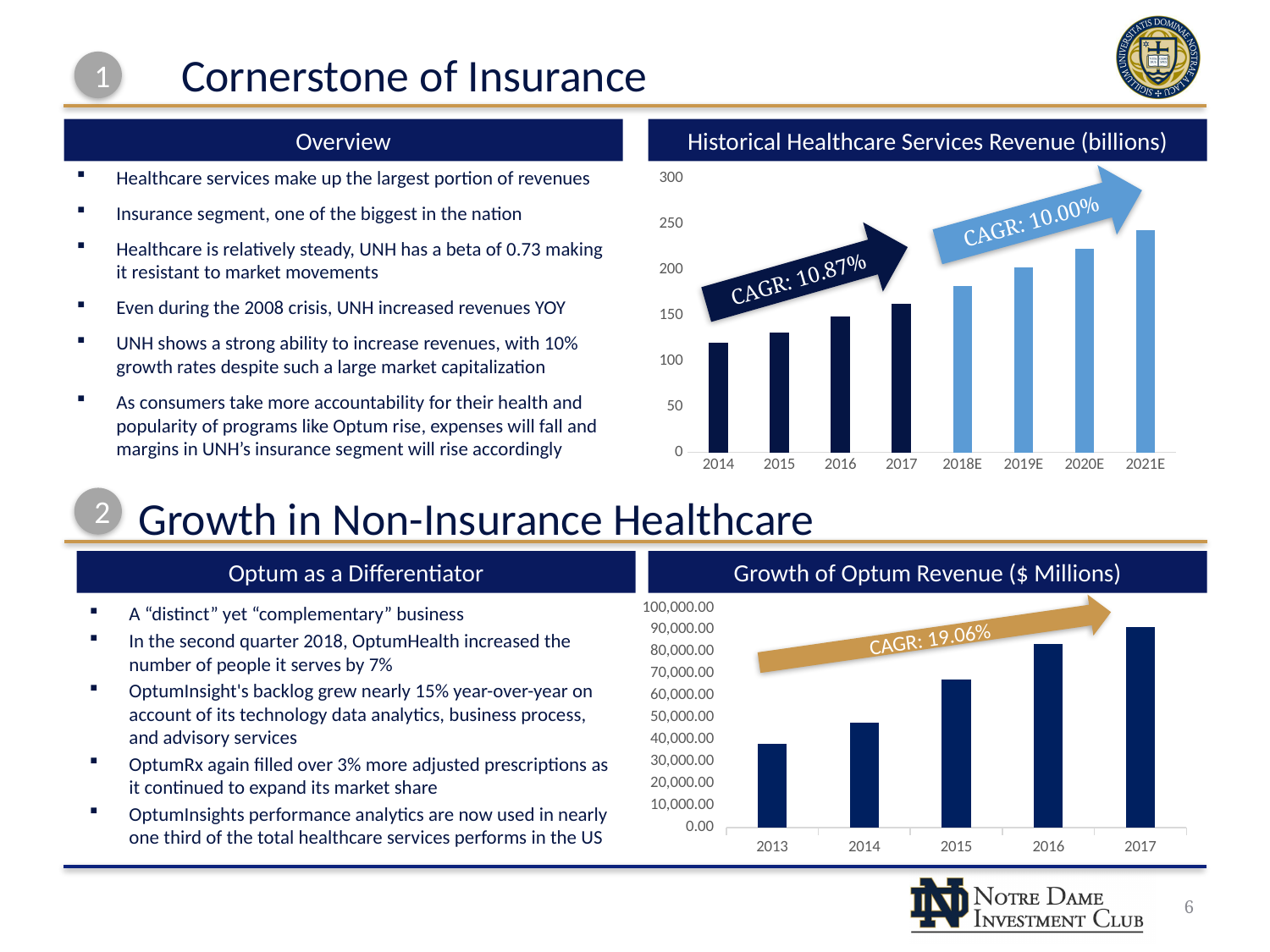
In the Historical Healthcare Services Revenue chart, is the value for 2019E greater or less than 250? less In the Historical Healthcare Services Revenue chart, is the value for 2017 greater or less than 150? greater In the Historical Healthcare Services Revenue chart, which year has the highest revenue? 2021E In the Historical Healthcare Services Revenue chart, what CAGR is shown for the historical (2014-2017) period? 10.87% In the Growth of Optum Revenue chart, is the value for 2015 greater or less than 60,000.00? greater In the Historical Healthcare Services Revenue chart, which year has the lowest revenue? 2014 In the Growth of Optum Revenue chart, which year has the highest revenue? 2017 In the Historical Healthcare Services Revenue chart, what kind of chart is used? bar chart In the Historical Healthcare Services Revenue chart, do the values rise or fall from 2014 to 2021E? rise In the Growth of Optum Revenue chart, how many years are shown? 5 In the Historical Healthcare Services Revenue chart, how many years are shown on the x axis? 8 In the Growth of Optum Revenue chart, which is larger, the value for 2014 or the value for 2016? 2016